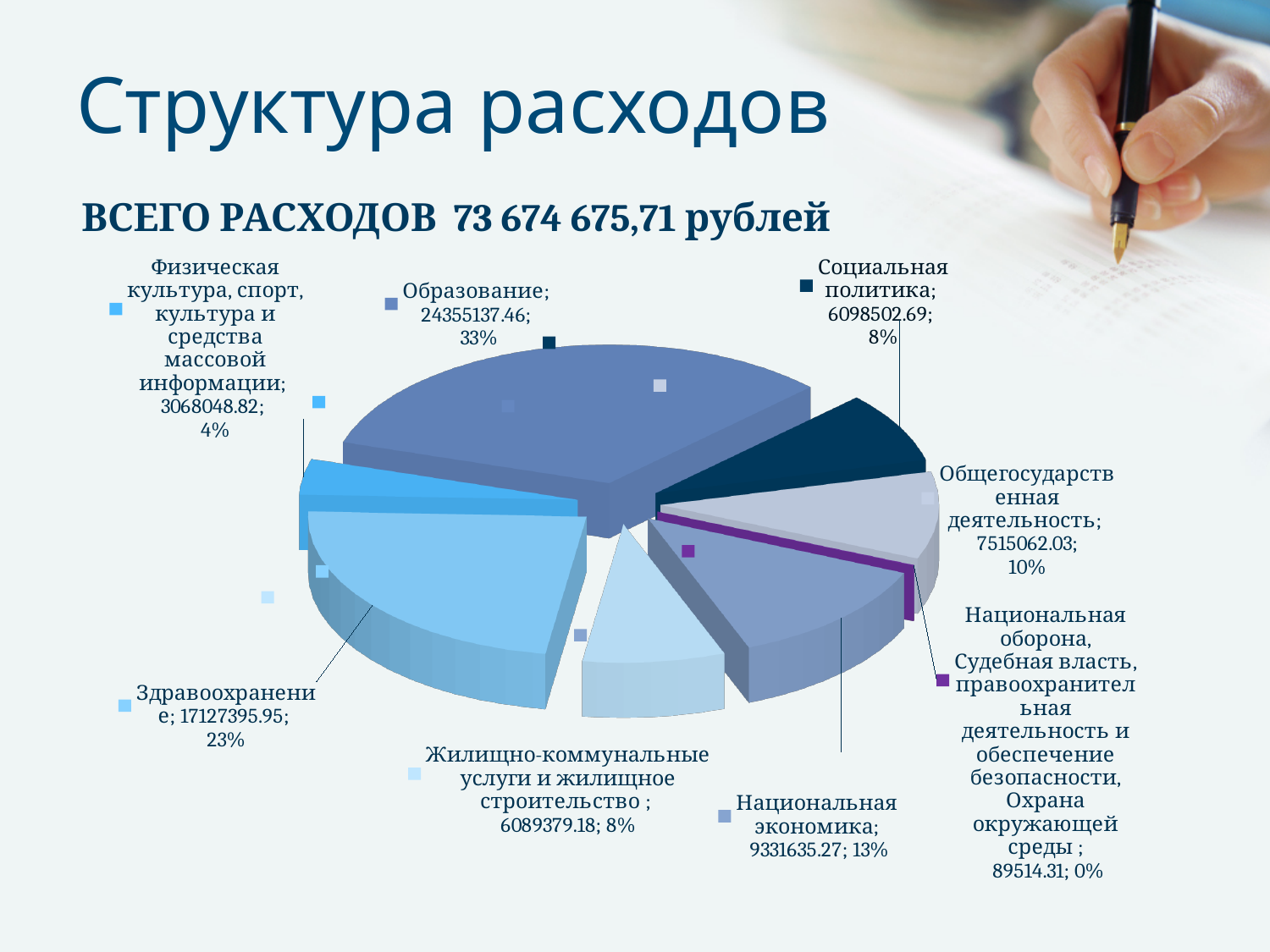
Which is larger: the value for Социальная политика or the value for Жилищно-коммунальные услуги и жилищное строительство? Социальная политика What is the value for Национальная экономика? 9331635.27 What kind of chart is shown on the slide? pie chart What share of the pie does Здравоохранение represent? 23% How many categories does the pie chart show? 8 What percentage is shown for Общегосударственная деятельность? 10% What is the value for Образование in the pie chart? 24355137.46 What total expenditure is stated above the chart? 73 674 675,71 рублей Which category has the largest share of the pie? Образование What share of the pie does Физическая культура, спорт, культура и средства массовой информации represent? 4% Which category has the smallest share of the pie? Национальная оборона, Судебная власть, правоохранительная деятельность и обеспечение безопасности, Охрана окружающей среды What is the difference between the values for Образование and Здравоохранение? 7227741.51